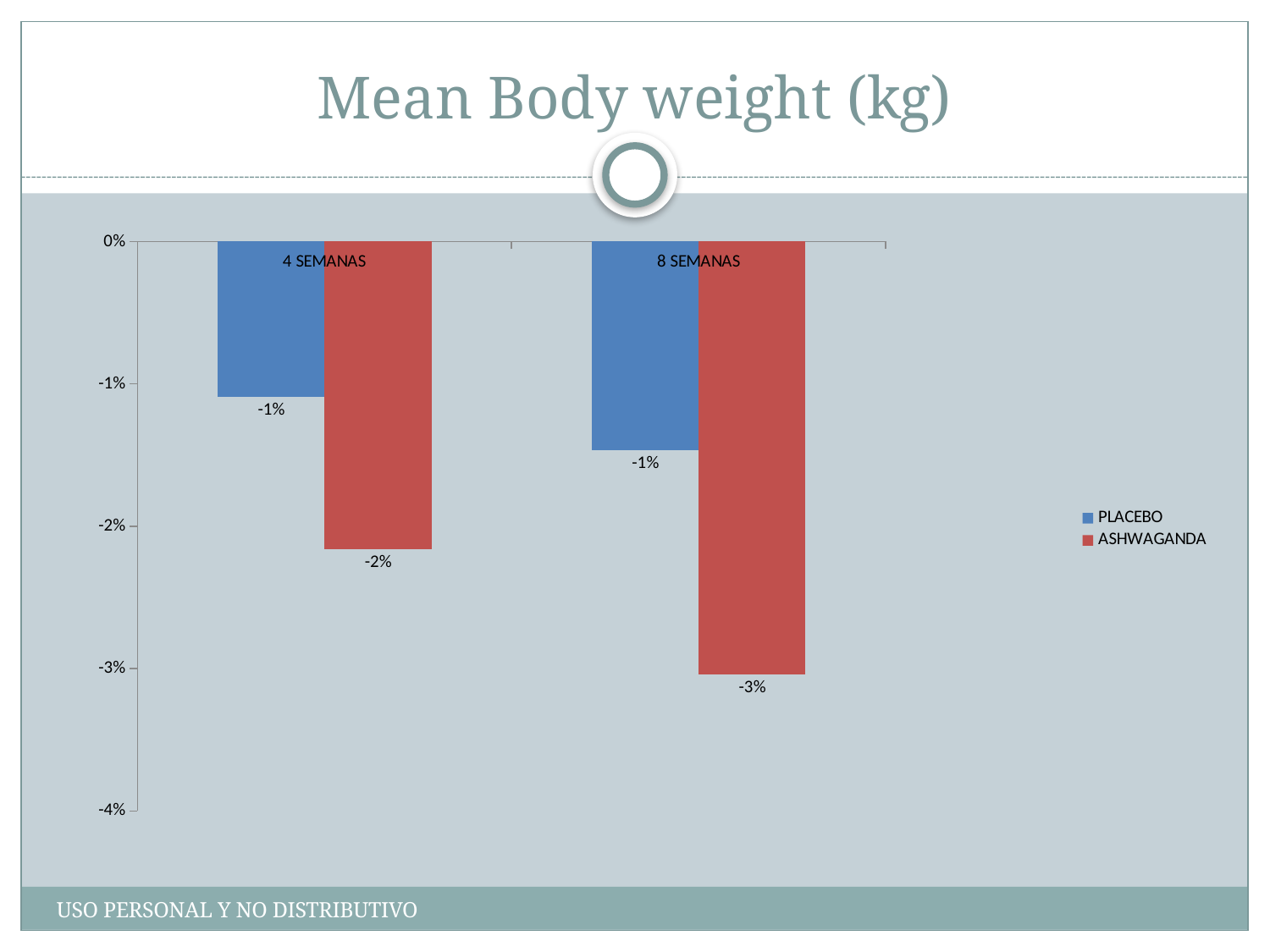
At 8 SEMANAS, which series has the larger (less negative) value, PLACEBO or ASHWAGANDA? PLACEBO Do the ASHWAGANDA values rise or fall from 4 SEMANAS to 8 SEMANAS? fall What is the value for ASHWAGANDA at 4 SEMANAS? -2% Is the value for ASHWAGANDA at 8 SEMANAS greater or less than -2%? less What is the value for PLACEBO at 4 SEMANAS? -1% How many series does the legend list? 2 What is the value for ASHWAGANDA at 8 SEMANAS? -3% Which colour represents the ASHWAGANDA series? red What is the title of the chart? Mean Body weight (kg) How many categories are shown on the x axis? 2 What type of chart is shown on the slide? bar chart Which bar has the lowest value in the chart? ASHWAGANDA at 8 SEMANAS